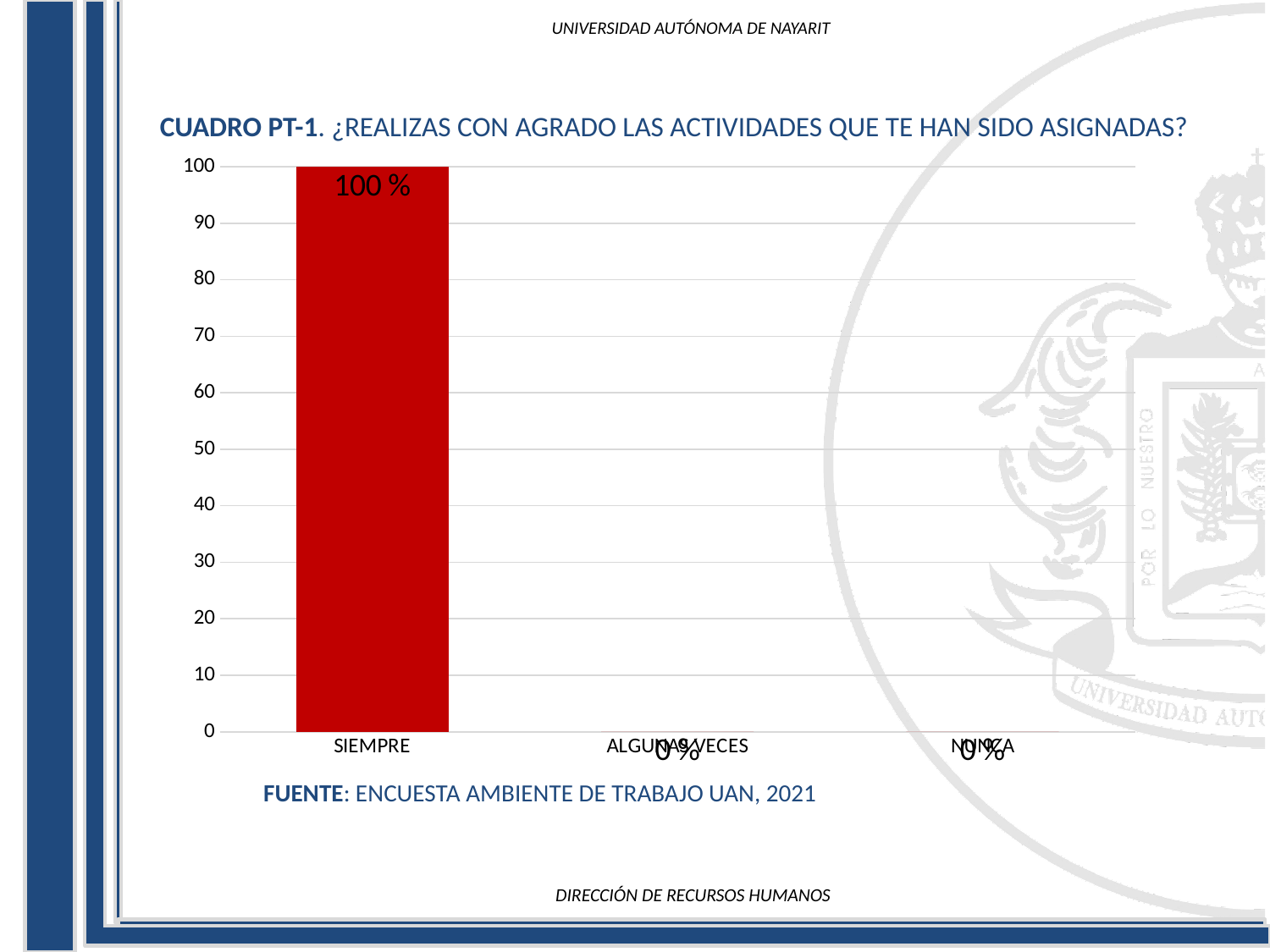
What is the value for SIEMPRE? 100 % What is the value for ALGUNAS VECES? 0 % What colour is the bar for SIEMPRE? red What kind of chart is shown on the slide? bar chart Is the value for SIEMPRE greater or less than 50? greater What is the value for NUNCA? 0 % Which is larger, the value for SIEMPRE or the value for ALGUNAS VECES? SIEMPRE What is the source cited below the chart? ENCUESTA AMBIENTE DE TRABAJO UAN, 2021 How many categories are shown on the x axis? 3 Which category has the highest value? SIEMPRE Do the values rise or fall from SIEMPRE to NUNCA along the x axis? fall What is the difference between the values for SIEMPRE and NUNCA? 100 %